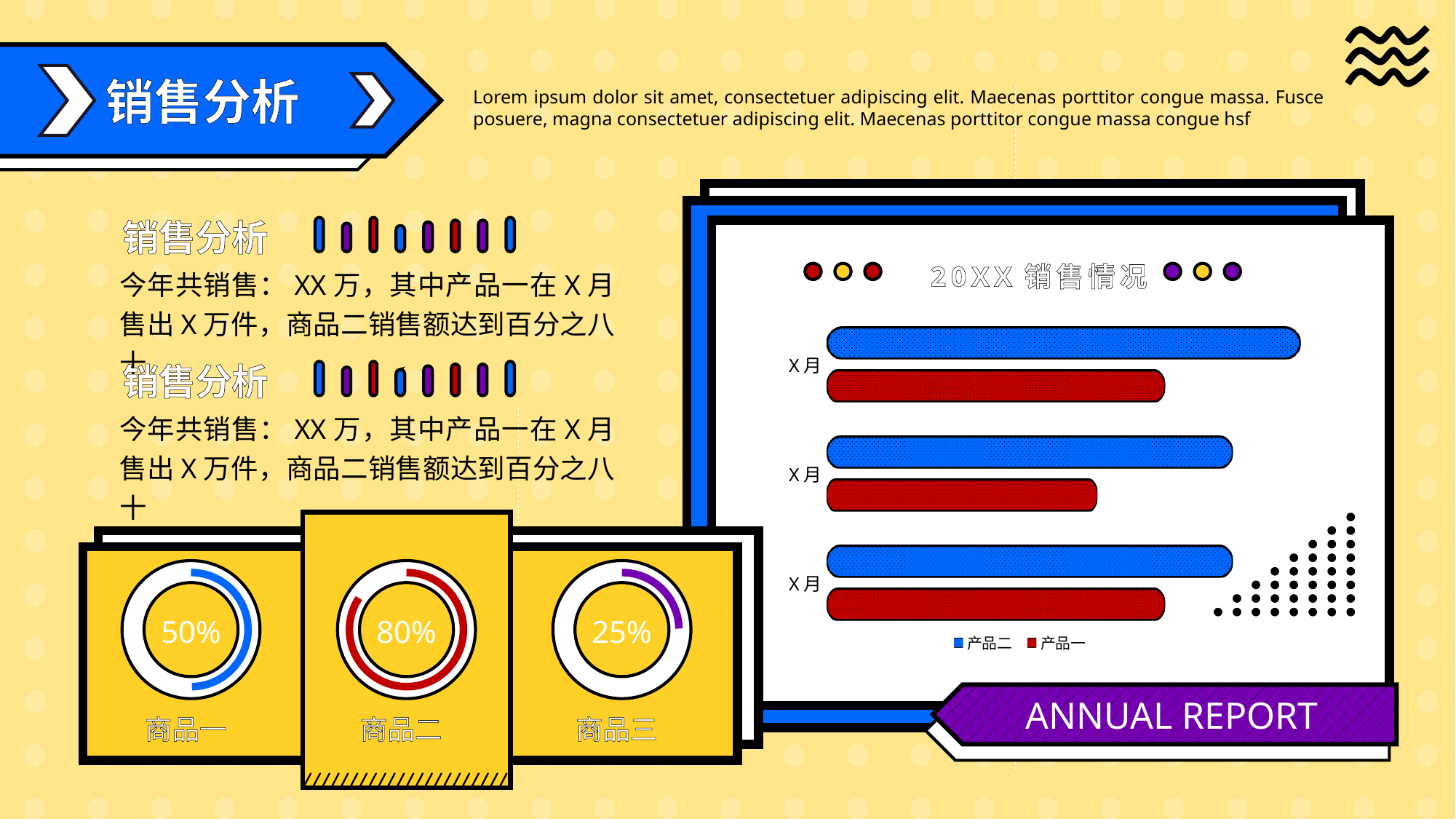
In the "20XX 销售情况" chart, which category group (top, middle or bottom) has the longest 产品二 bar? top What kind of chart is the "20XX 销售情况" chart? bar chart In the ring gauges at the bottom left, what is the difference between the percentages for 商品二 and 商品一? 30% How many category groups are plotted in the "20XX 销售情况" chart? 3 Among the three ring gauges at the bottom left, which item has the lowest percentage? 商品三 In the top category group of the "20XX 销售情况" chart, which series has the longer bar, 产品二 or 产品一? 产品二 In the "20XX 销售情况" chart, which category group (top, middle or bottom) has the shortest 产品一 bar? middle In the "20XX 销售情况" chart, which colour represents 产品一? red How many series does the legend of the "20XX 销售情况" chart list? 2 In the middle category group of the "20XX 销售情况" chart, which series has the longer bar, 产品二 or 产品一? 产品二 In the ring gauges at the bottom left, what percentage is shown for 商品二? 80% What are the two legend entries in the "20XX 销售情况" chart? 产品二 and 产品一